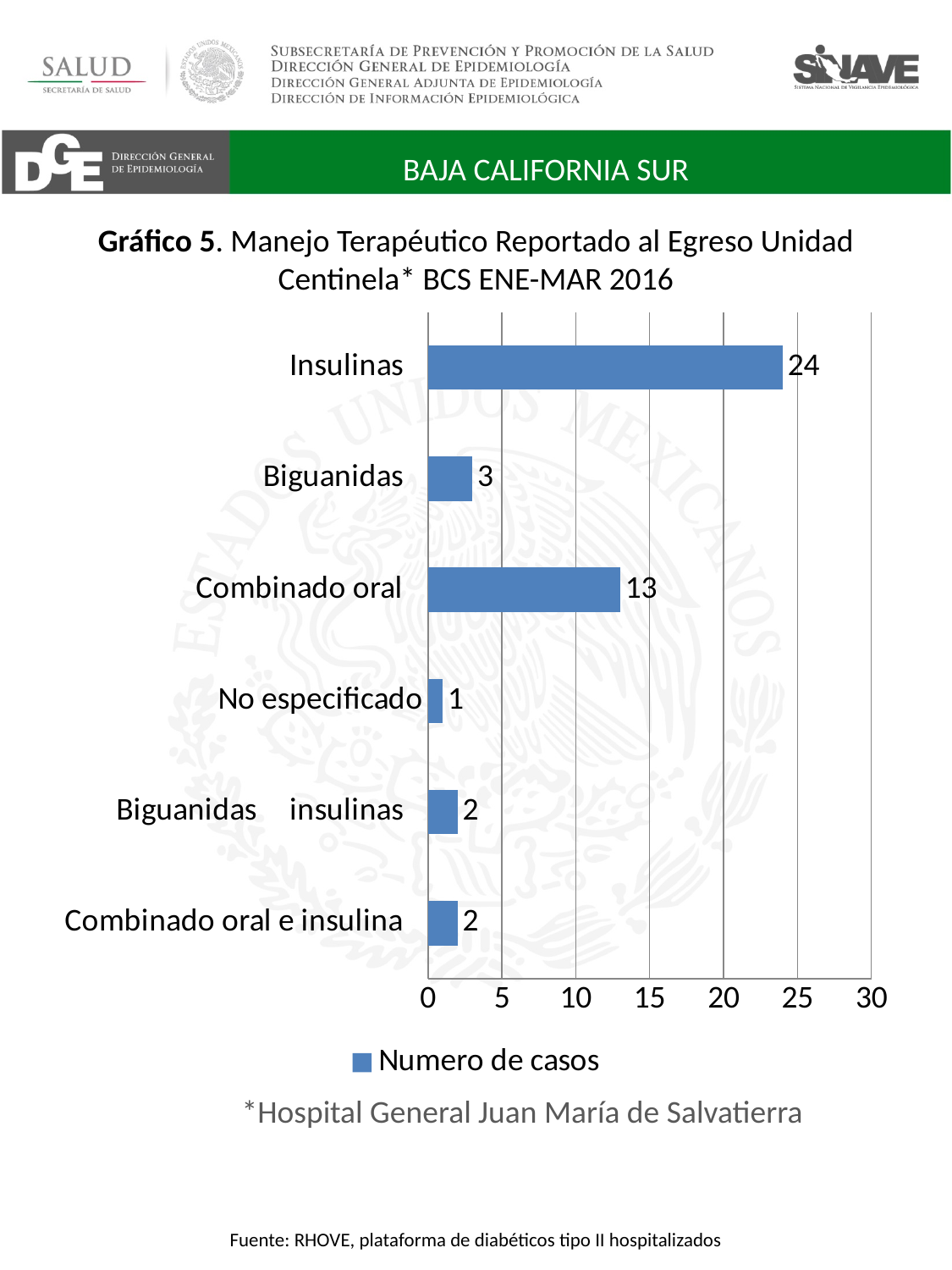
What kind of chart is shown on the slide? Bar chart Which has more cases, Biguanidas or Combinado oral? Combinado oral What is the number of cases for Biguanidas? 3 What is the number of cases for Combinado oral? 13 Which category has the highest number of cases? Insulinas What is the legend entry of the chart? Numero de casos What is the difference in number of cases between Insulinas and Combinado oral? 11 What is the number of cases for Insulinas? 24 How many categories are shown in the chart? 6 Which category has the lowest number of cases? No especificado What is the number of cases for No especificado? 1 How many series does the legend list? 1